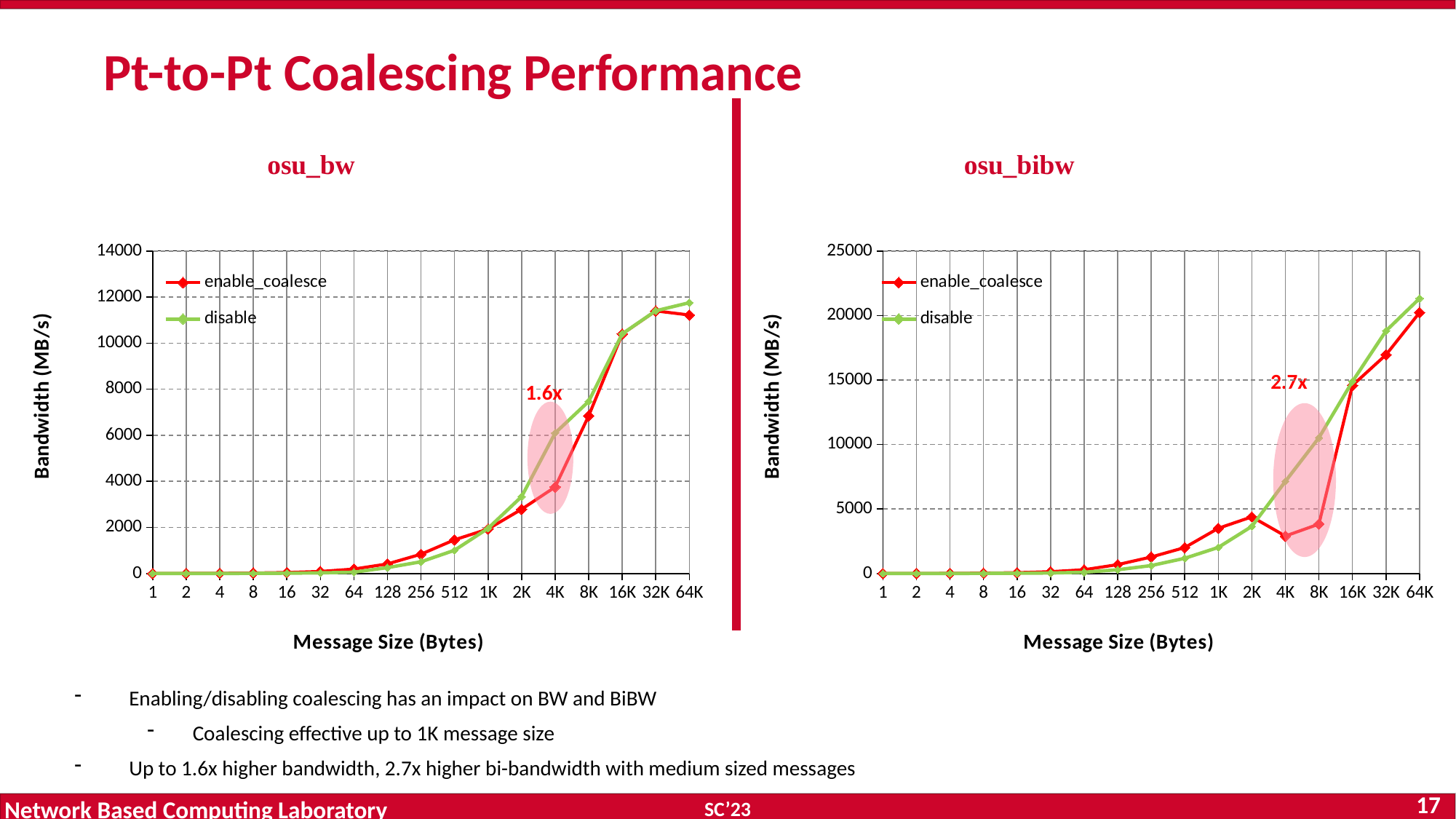
In the osu_bibw chart, does the disable series rise or fall as message size increases from 1K to 64K? rise In the osu_bw chart, is the disable value at 8K greater or less than 6000? greater In the osu_bibw chart, is the enable_coalesce value at 4K greater or less than 5000? less What speedup annotation is shown on the osu_bibw chart? 2.7x In the osu_bw chart, is the enable_coalesce value at 4K greater or less than 6000? less In the osu_bw chart, which series has the higher bandwidth at message size 4K? disable How many series does the legend of the osu_bibw chart list? 2 How many message sizes are plotted along the x axis of the osu_bw chart? 17 In the osu_bibw chart, which series has the higher bandwidth at message size 2K? enable_coalesce What kind of chart is the osu_bw chart? line chart In the osu_bibw chart, at which message size does the disable series reach its highest bandwidth? 64K